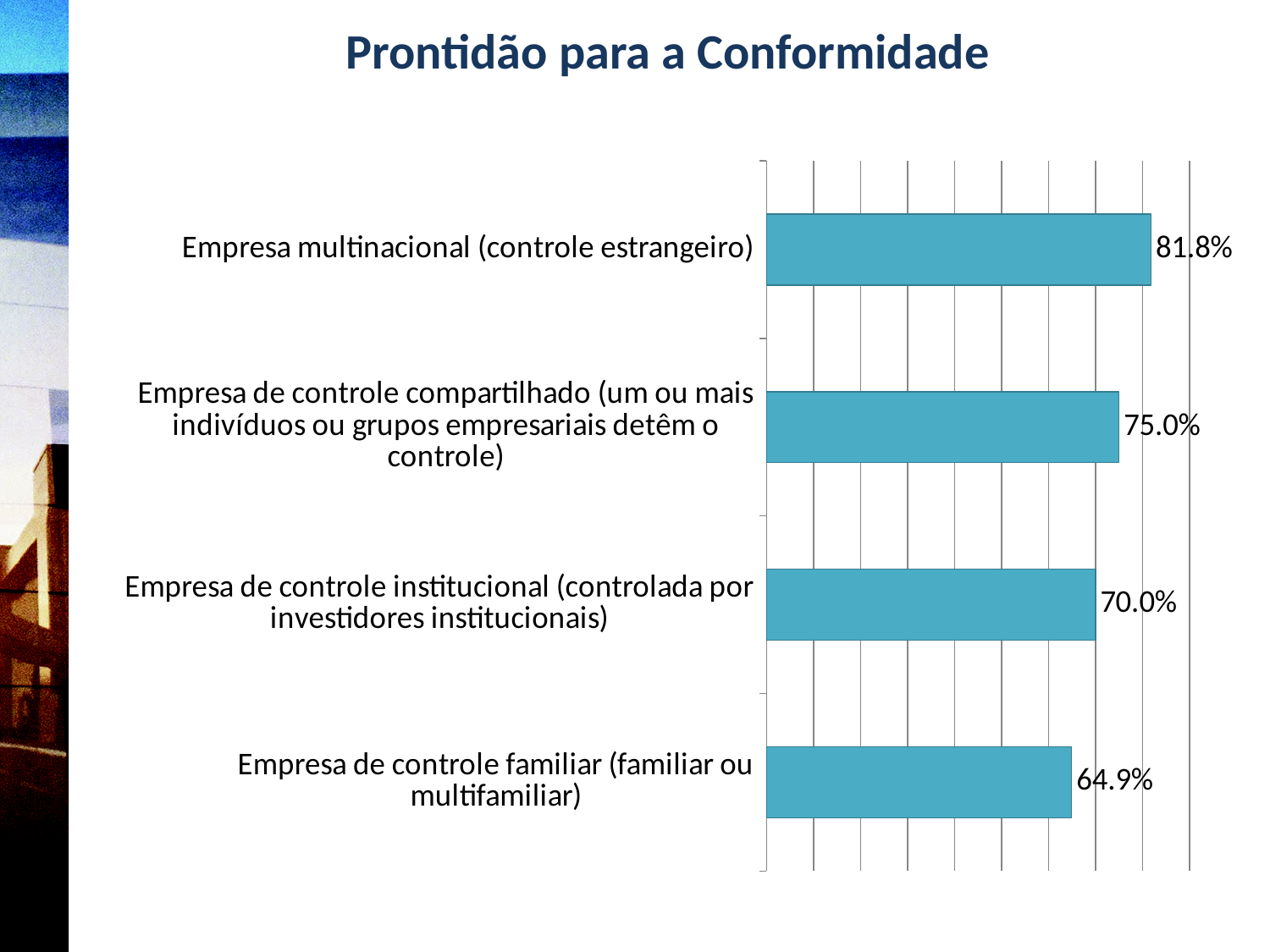
How many categories are shown in the chart? 4 What is the difference between the values for Empresa de controle compartilhado and Empresa de controle institucional? 5.0% What kind of chart is shown on the slide? Bar chart Which category has the lowest value? Empresa de controle familiar (familiar ou multifamiliar) What is the difference between the values for Empresa multinacional (controle estrangeiro) and Empresa de controle familiar (familiar ou multifamiliar)? 16.9% What is the value for Empresa de controle familiar (familiar ou multifamiliar)? 64.9% Which is larger: the value for Empresa de controle institucional or the value for Empresa de controle familiar? Empresa de controle institucional What is the value for Empresa de controle compartilhado? 75.0% What is the title of the slide? Prontidão para a Conformidade What is the value for Empresa de controle institucional (controlada por investidores institucionais)? 70.0% What is the value for Empresa multinacional (controle estrangeiro)? 81.8% Which category has the highest value? Empresa multinacional (controle estrangeiro)